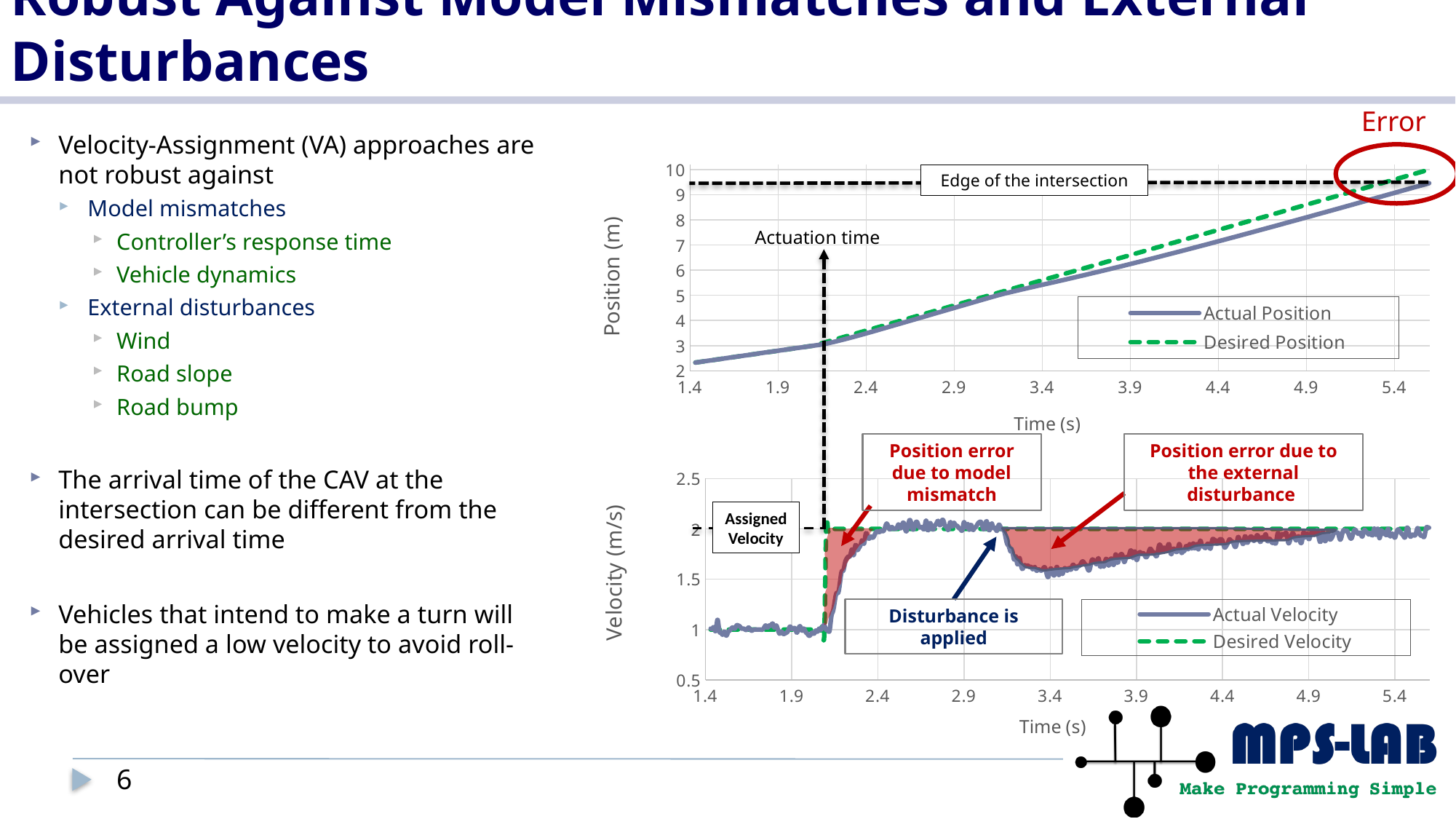
In the bottom chart (Velocity vs Time), what is the Assigned Velocity value in m/s? 2 In the top chart (Position vs Time), does the Actual Position rise or fall as time increases? rise In the top chart (Position vs Time), at 4.9 s which series is higher, Actual Position or Desired Position? Desired Position In the top chart (Position vs Time), is the Desired Position at 5.4 s greater or less than 9? greater In the bottom chart (Velocity vs Time), which series is drawn as a green dashed line? Desired Velocity How many series does the legend of the top chart (Position vs Time) list? 2 In the top chart (Position vs Time), is the Actual Position at 1.4 s greater or less than 3? less In the bottom chart (Velocity vs Time), is the Desired Velocity at 1.9 s greater or less than 1.5? less What kind of chart is the top chart (Position vs Time)? line chart How many series does the legend of the bottom chart (Velocity vs Time) list? 2 What kind of chart is the bottom chart (Velocity vs Time)? line chart